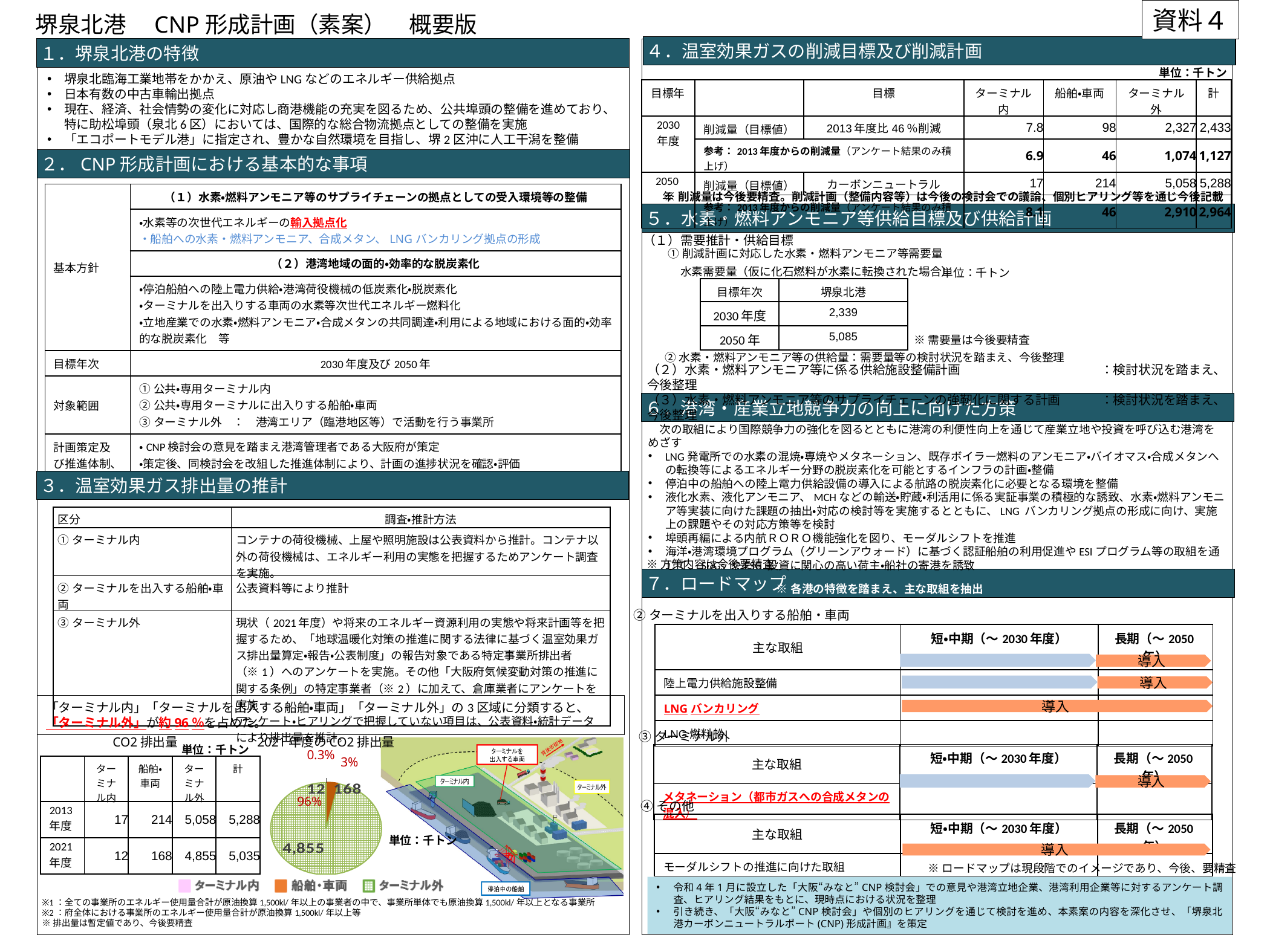
In the 2021年度のCO2排出量 pie chart, which category has the largest slice? ターミナル外 How many categories does the legend of the 2021年度のCO2排出量 pie chart list? 3 What kind of chart is shown in the 2021年度のCO2排出量 figure? pie chart In the 2021年度のCO2排出量 pie chart, which category has the smallest slice? ターミナル内 In the 2021年度のCO2排出量 pie chart, what is the value for ターミナル外? 4,855 In the 2021年度のCO2排出量 pie chart, what is the value for 船舶・車両? 168 In the 2021年度のCO2排出量 pie chart, what share of the total does ターミナル外 account for? 96% In the 2021年度のCO2排出量 pie chart, what share of the total does ターミナル内 account for? 0.3% In the 2021年度のCO2排出量 pie chart, what share of the total does 船舶・車両 account for? 3% In the 2021年度のCO2排出量 pie chart, what is the difference between the values for 船舶・車両 and ターミナル内? 156 In the 2021年度のCO2排出量 pie chart, which is larger, 船舶・車両 or ターミナル内? 船舶・車両 In the 2021年度のCO2排出量 pie chart, what is the value for ターミナル内? 12